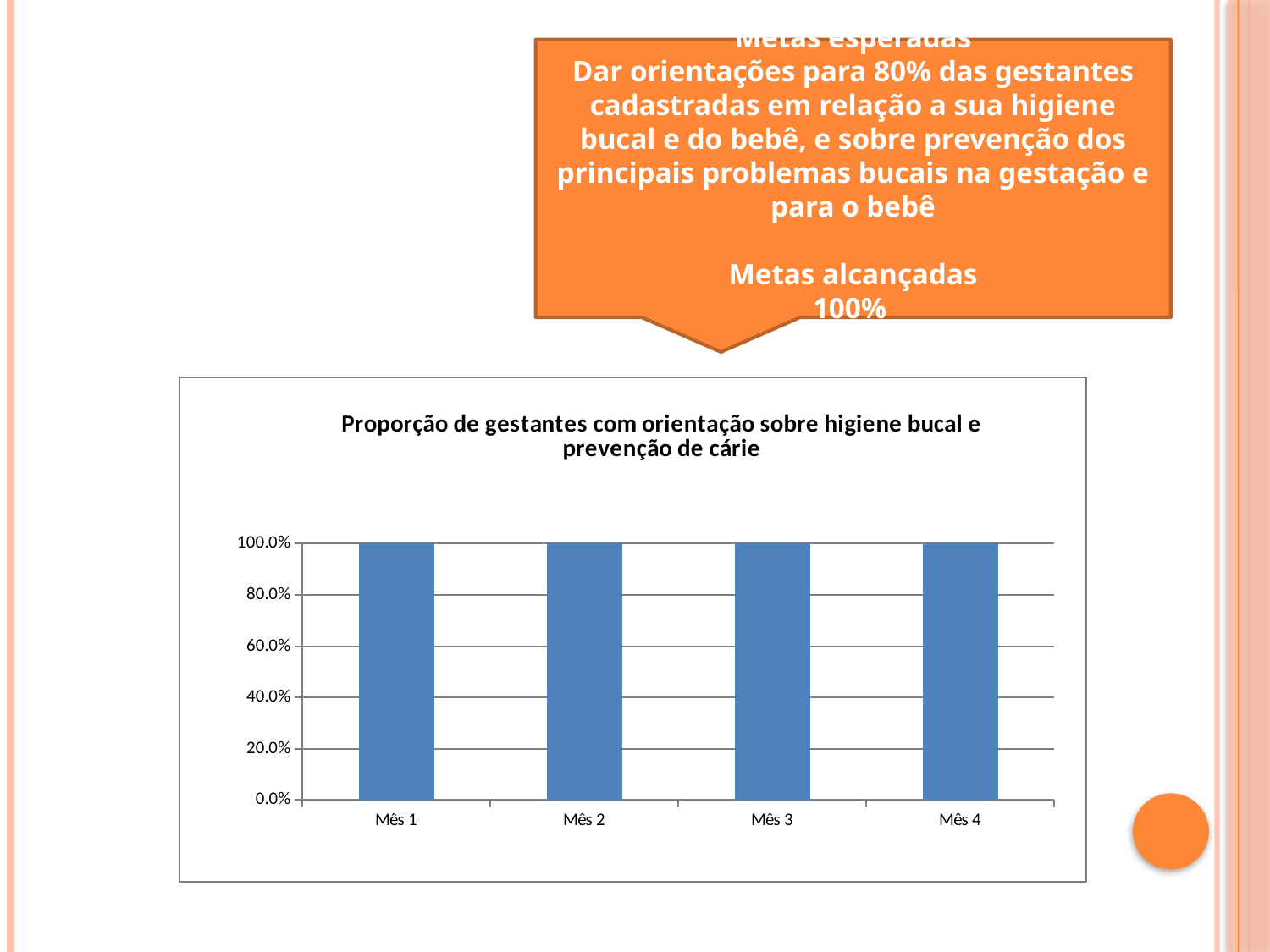
Is the value for Mês 4 greater or less than 60.0%? greater What is the value for Mês 3? 100.0% What is the value for Mês 4? 100.0% What is the label of the first category on the x axis? Mês 1 Do the values rise, fall, or stay flat from Mês 1 to Mês 4? stay flat What is the title of the chart? Proporção de gestantes com orientação sobre higiene bucal e prevenção de cárie What is the value for Mês 2? 100.0% Is the value for Mês 2 greater or less than 80.0%? greater What is the value for Mês 1? 100.0% What is the difference between the values for Mês 1 and Mês 4? 0.0% How many categories (months) are plotted on the x axis? 4 What type of chart is shown on the slide? bar chart